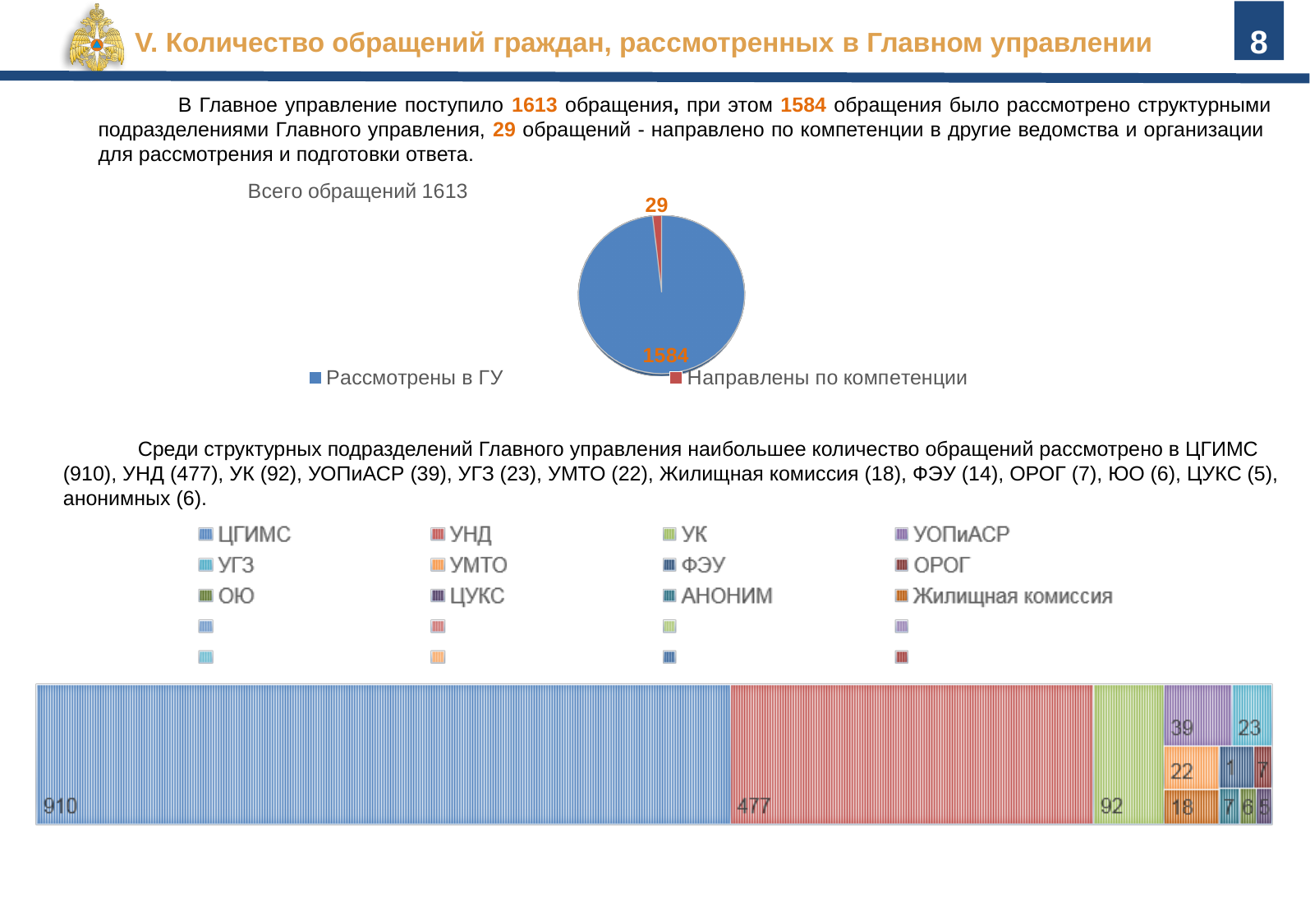
In the bottom chart, which category has the highest value? ЦГИМС In the pie chart 'Всего обращений 1613', what is the value for 'Направлены по компетенции'? 29 How many entries does the legend of the pie chart 'Всего обращений 1613' list? 2 In the pie chart 'Всего обращений 1613', what is the difference between 'Рассмотрены в ГУ' and 'Направлены по компетенции'? 1555 In the bottom chart, what is the value for УНД? 477 In the bottom chart, what is the value for УК? 92 In the bottom chart, what is the value for ЦГИМС? 910 In the pie chart 'Всего обращений 1613', what is the value for 'Рассмотрены в ГУ'? 1584 In the bottom chart, what is the difference between the values for ЦГИМС and УНД? 433 In the pie chart 'Всего обращений 1613', which slice is the largest? Рассмотрены в ГУ In the pie chart 'Всего обращений 1613', what is the total of the two slices? 1613 What kind of chart is the upper chart titled 'Всего обращений 1613'? pie chart